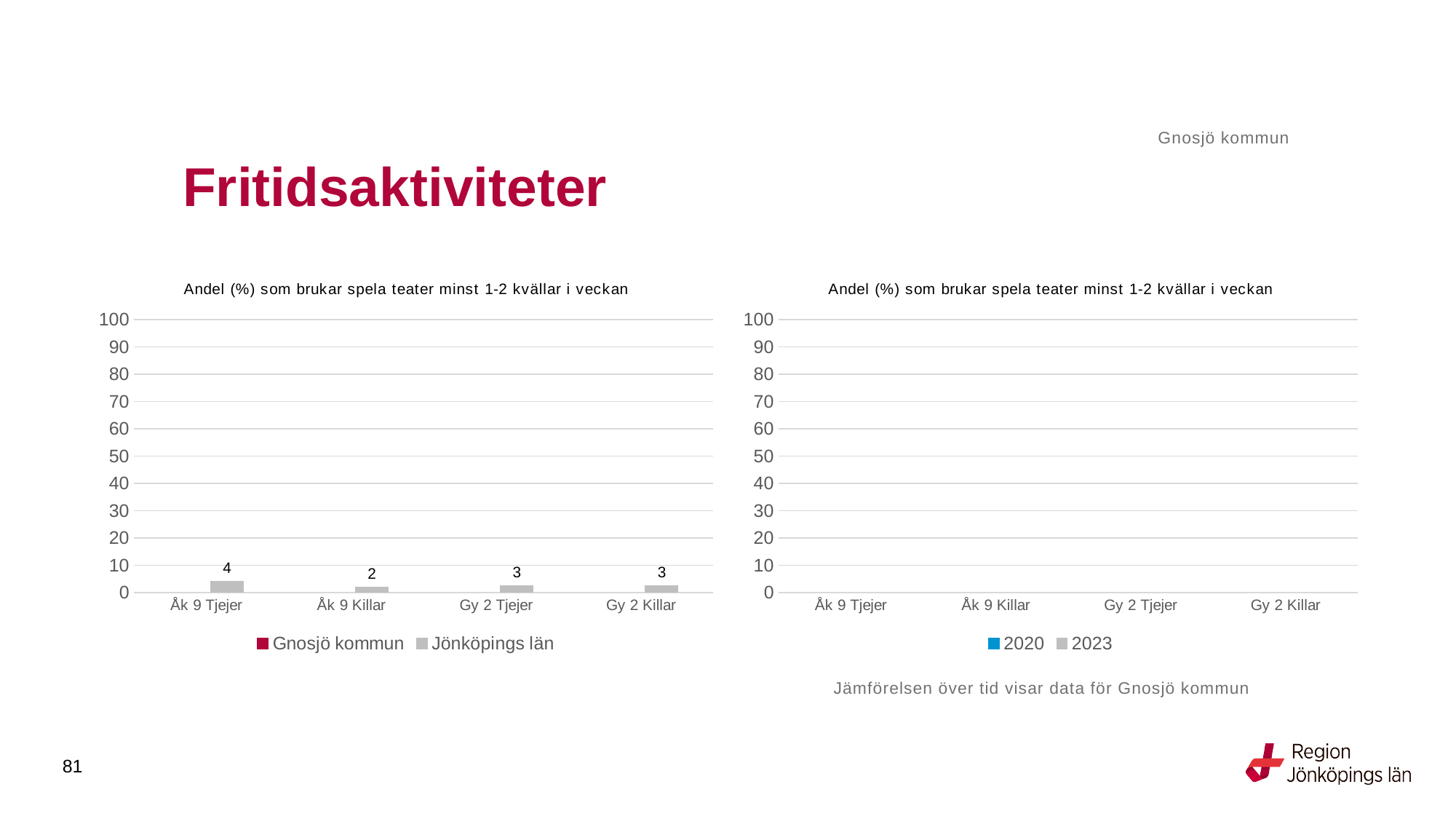
In the left chart, which category has the highest value for Jönköpings län? Åk 9 Tjejer How many categories are shown on the x axis of the left chart? 4 In the left chart, which is larger for Jönköpings län: Åk 9 Tjejer or Gy 2 Killar? Åk 9 Tjejer In the left chart, what is the value for Jönköpings län for Gy 2 Tjejer? 3 In the left chart, what is the value for Jönköpings län for Åk 9 Tjejer? 4 What are the legend entries of the right chart? 2020 and 2023 What kind of chart is the left chart? bar chart In the left chart, what is the value for Jönköpings län for Åk 9 Killar? 2 How many series does the legend of the right chart list? 2 In the left chart, what is the difference between the Jönköpings län values for Åk 9 Tjejer and Åk 9 Killar? 2 In the left chart, is the Jönköpings län value for Åk 9 Tjejer greater or less than 10? less In the left chart, which category has the lowest value for Jönköpings län? Åk 9 Killar